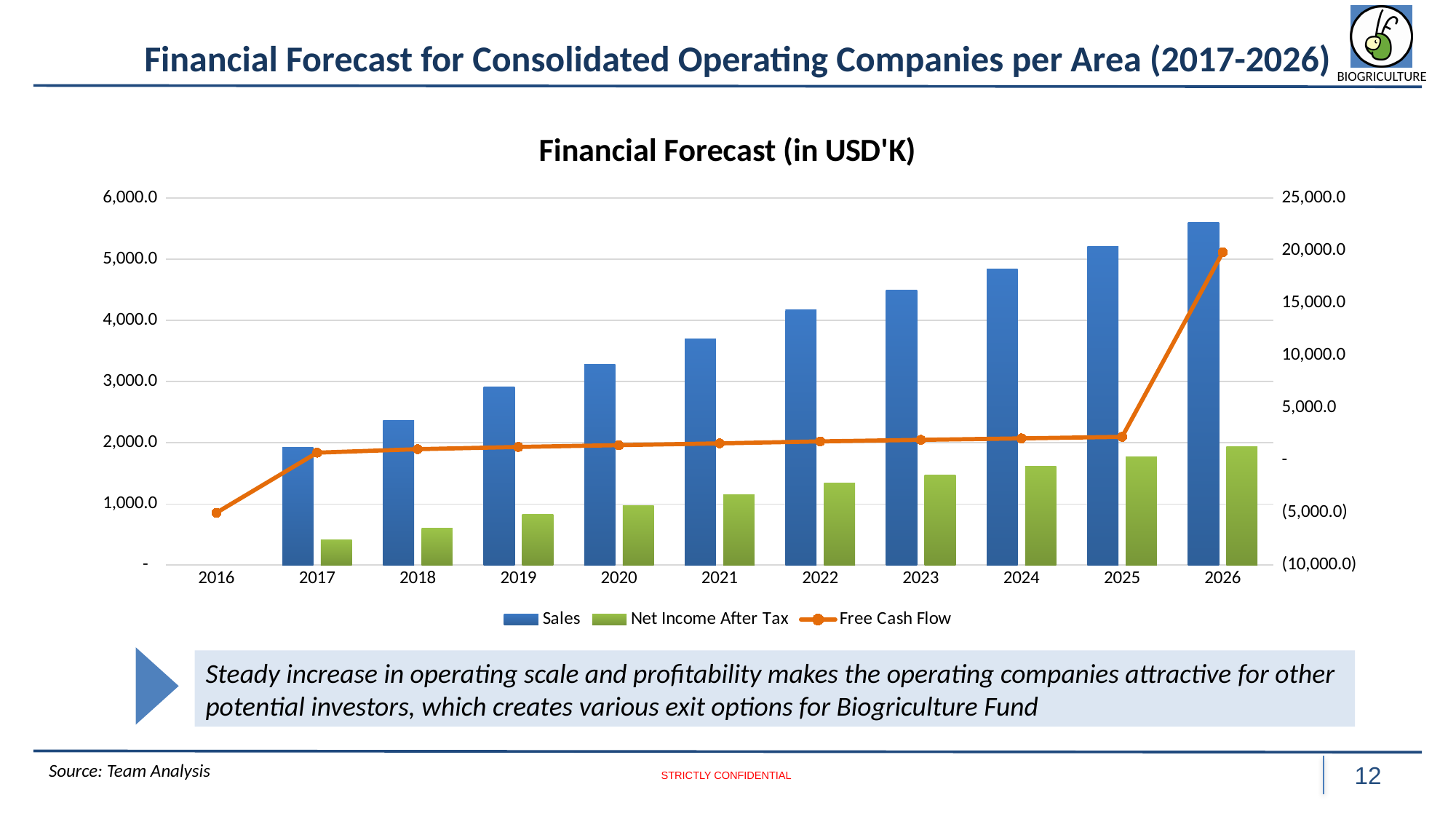
What kind of chart is shown on the slide? Combined bar and line chart Is the Free Cash Flow value for 2026 greater or less than 15,000.0 on the right axis? greater Do Sales rise or fall from 2017 to 2026? rise In which year is Sales highest? 2026 Is the Sales value for 2020 greater or less than 3,000.0? greater How many years are shown on the x axis? 11 In which year is Net Income After Tax lowest among the years with a bar? 2017 Is the Net Income After Tax value for 2017 greater or less than 1,000.0? less Which is larger in 2026, Sales or Net Income After Tax? Sales What is the title of the chart? Financial Forecast (in USD'K) How many series does the legend list? 3